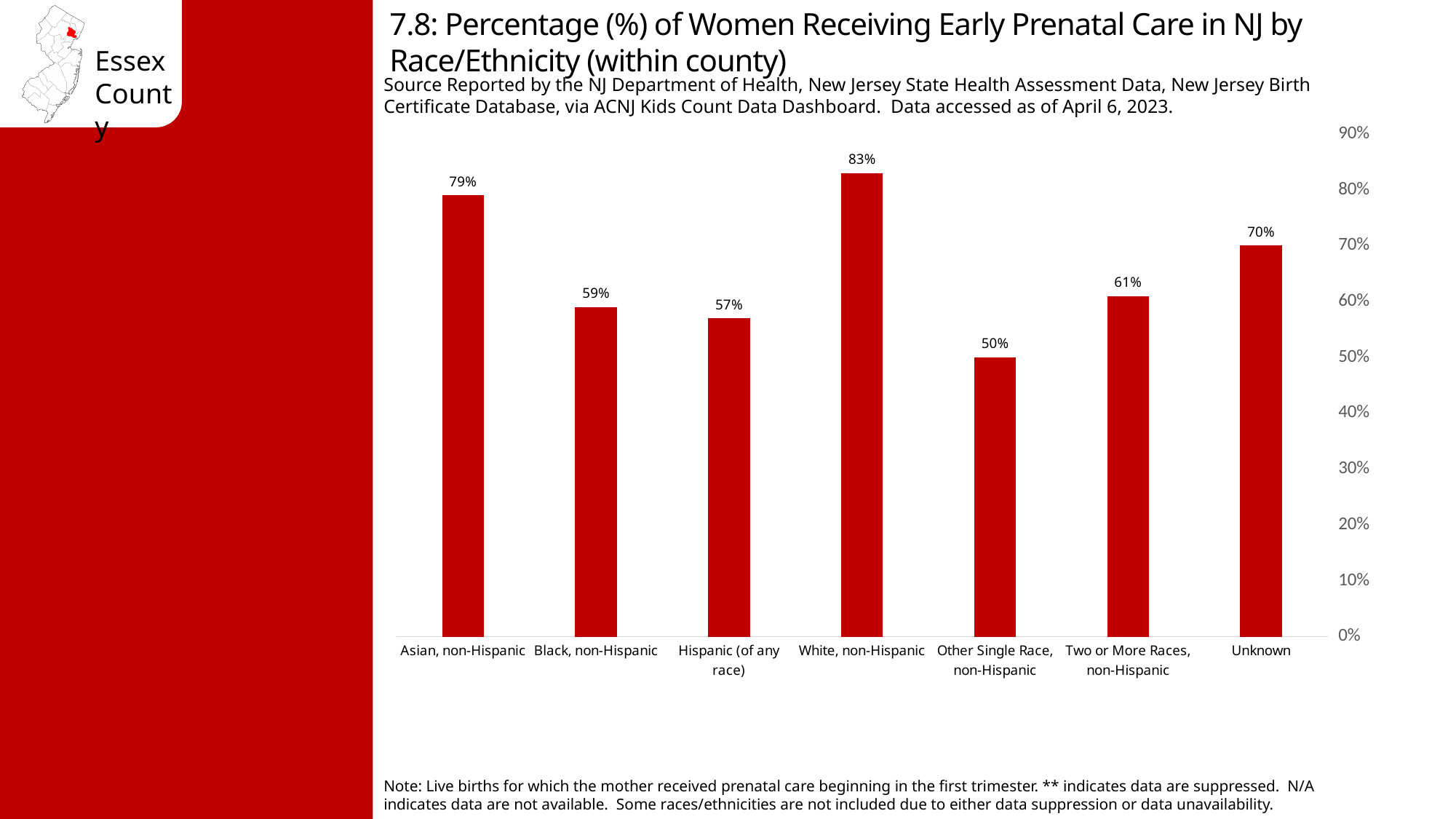
What is the value for Unknown? 70% Which is larger, the value for Two or More Races, non-Hispanic or the value for Hispanic (of any race)? Two or More Races, non-Hispanic What is the difference between the values for Asian, non-Hispanic and Hispanic (of any race)? 22% Which race/ethnicity category has the highest percentage of women receiving early prenatal care? White, non-Hispanic Is the value for Black, non-Hispanic greater or less than 60%? less What is the difference between the values for White, non-Hispanic and Black, non-Hispanic? 24% What percentage of Asian, non-Hispanic women received early prenatal care? 79% What is the maximum value shown on the vertical axis? 90% How many race/ethnicity categories are shown on the chart? 7 Which race/ethnicity category has the lowest percentage? Other Single Race, non-Hispanic What is the value for Other Single Race, non-Hispanic? 50% What kind of chart is shown on the slide? Bar chart